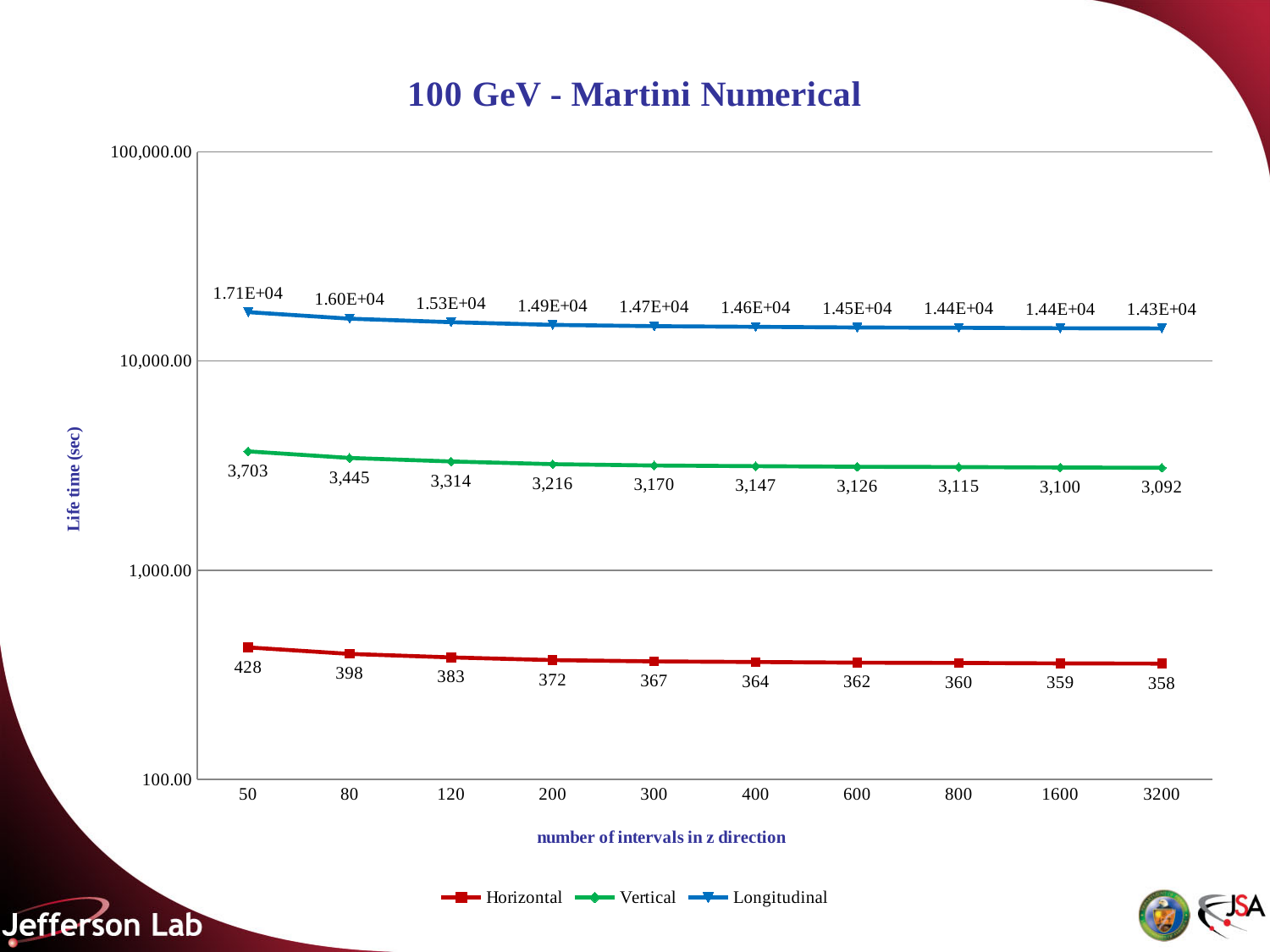
How many x-axis categories (numbers of intervals) are plotted? 10 How many series does the legend list? 3 What is the Longitudinal life time at 3200 intervals in z direction? 1.43E+04 What is the Horizontal life time at 50 intervals in z direction? 428 What is the Vertical life time at 200 intervals in z direction? 3,216 What kind of chart is shown? line chart At which number of intervals is the Vertical life time highest? 50 At which number of intervals is the Horizontal life time lowest? 3200 Which is larger at 120 intervals: the Vertical life time or the Horizontal life time? Vertical Is the Vertical life time at 400 intervals greater or less than 1,000.00? greater Does the Horizontal life time rise or fall as the number of intervals increases? fall What is the difference between the Horizontal life time at 50 intervals and at 80 intervals? 30